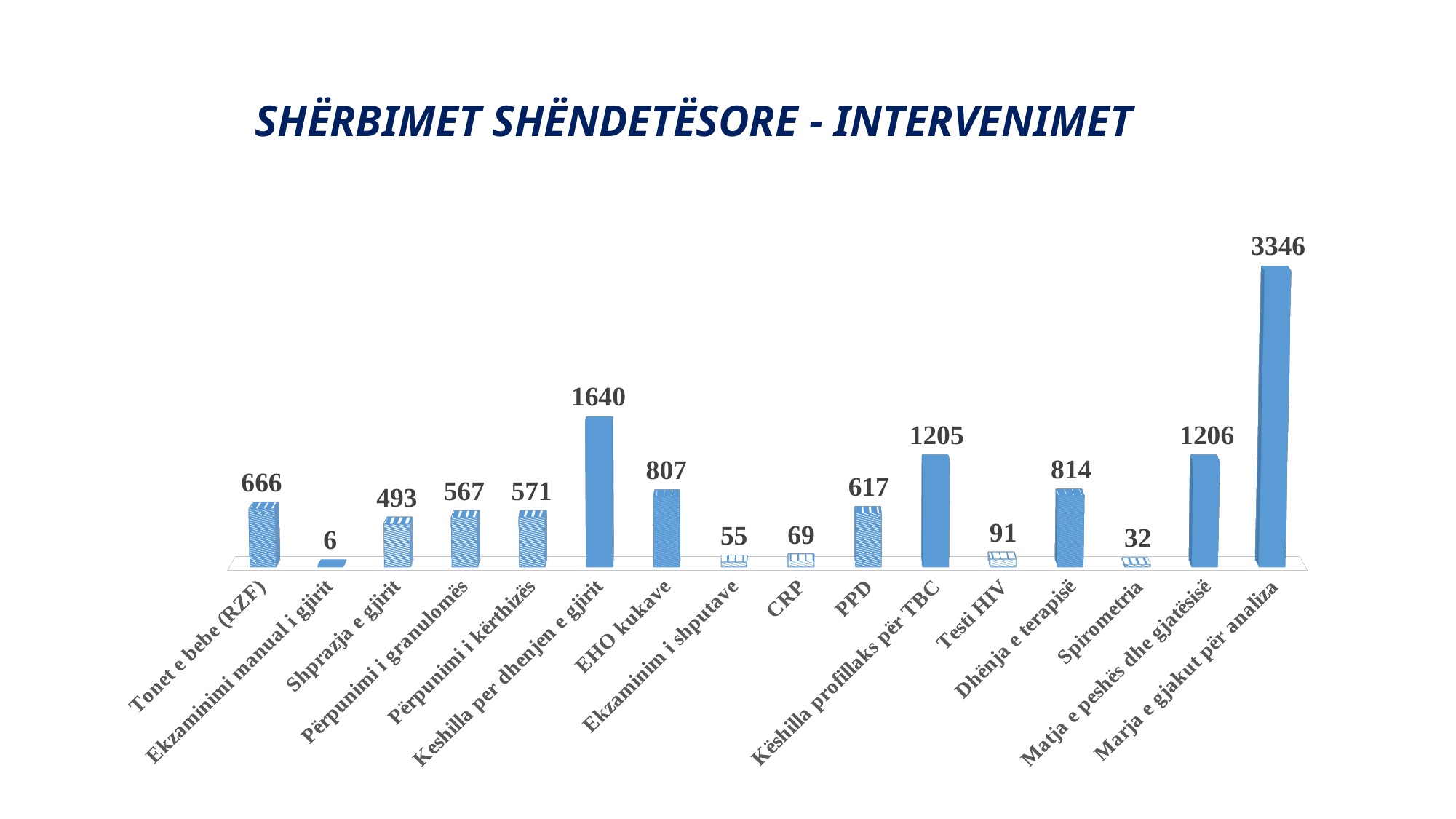
How many categories are shown in the chart? 16 Which category has the highest value? Marja e gjakut për analiza What is the value for Marja e gjakut për analiza? 3346 What is the title of the slide? SHËRBIMET SHËNDETËSORE - INTERVENIMET What is the difference between the values for Marja e gjakut për analiza and Keshilla per dhenjen e gjirit? 1706 What is the value for Spirometria? 32 Which is larger, the value for Dhënja e terapisë or the value for PPD? Dhënja e terapisë What is the difference between the values for EHO kukave and Tonet e bebe (RZF)? 141 Which category has the lowest value? Ekzaminimi manual i gjirit What kind of chart is shown on the slide? Bar chart What is the value for Testi HIV? 91 What is the value for Keshilla per dhenjen e gjirit? 1640